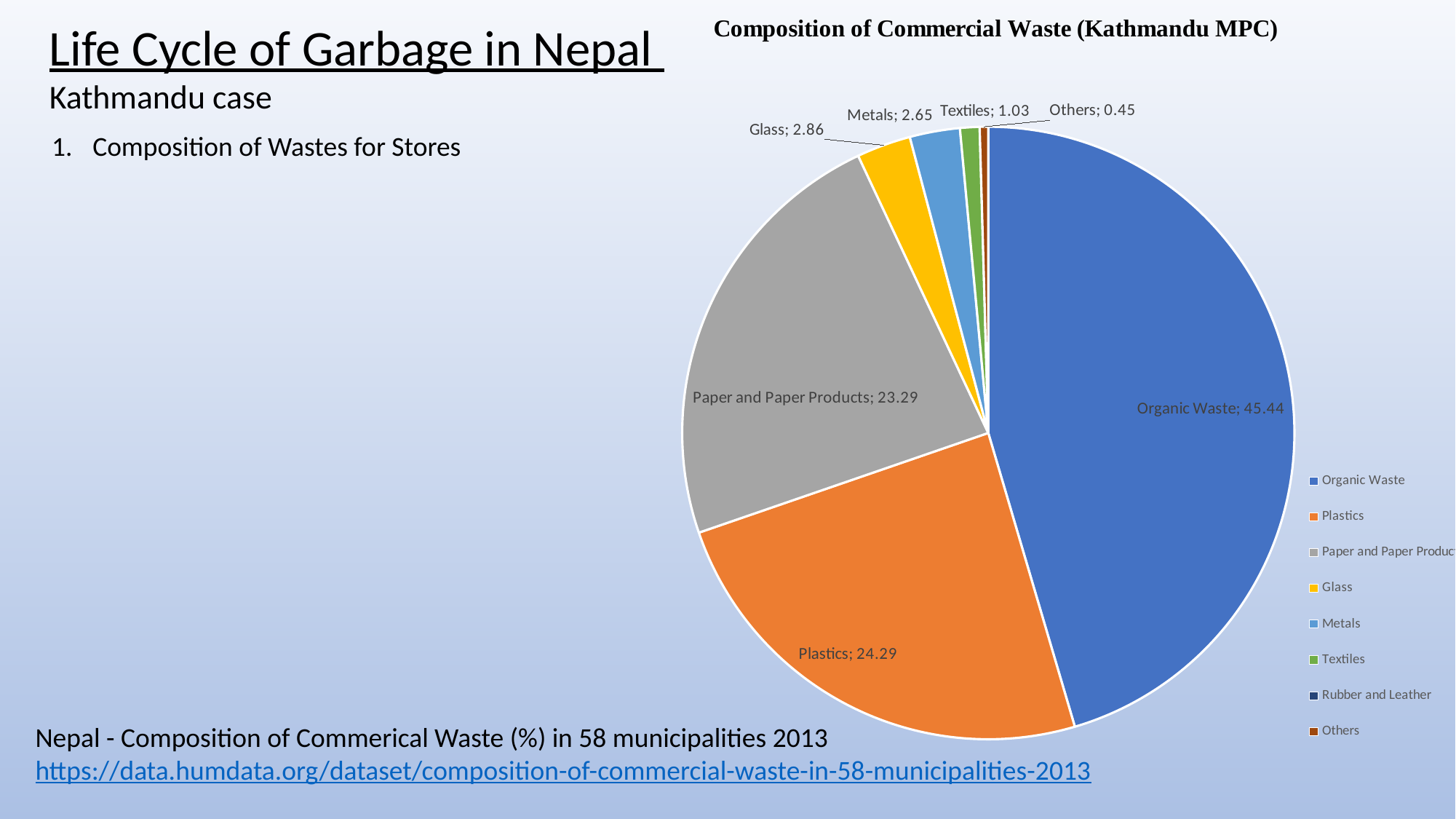
How many entries does the legend list? 8 Which labelled category has the smallest slice of the pie? Others Which category has the largest slice of the pie? Organic Waste What is the value for Textiles? 1.03 What is the value for Plastics? 24.29 What is the value for Organic Waste? 45.44 What is the title of the chart? Composition of Commercial Waste (Kathmandu MPC) Which is larger, the value for Plastics or the value for Paper and Paper Products? Plastics What is the value for Paper and Paper Products? 23.29 What is the value for Glass? 2.86 What type of chart is shown on the slide? Pie chart What is the difference between the values for Organic Waste and Plastics? 21.15